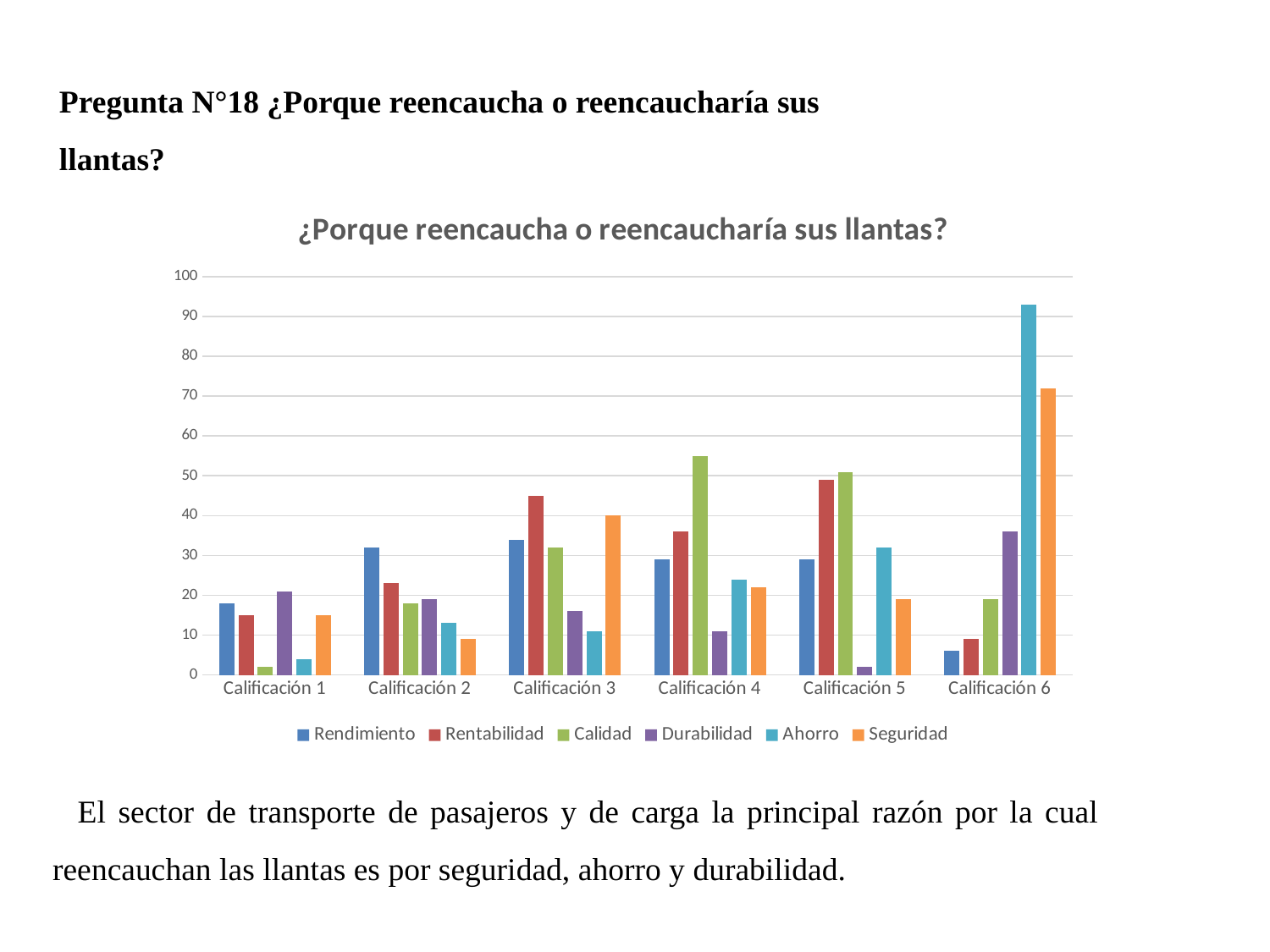
Which series has the highest bar in Calificación 6? Ahorro How many categories (Calificación groups) are shown on the x axis? 6 Which category contains the tallest bar in the whole chart? Calificación 6 How many series does the legend list? 6 Is the value for Rendimiento in Calificación 6 greater or less than 10? less Is the value for Calidad in Calificación 4 greater or less than 50? greater Is the value for Ahorro in Calificación 6 greater or less than 80? greater Which series has the lowest bar in Calificación 5? Durabilidad What kind of chart is shown on the slide? Bar chart In Calificación 3, which is larger: Rentabilidad or Seguridad? Rentabilidad What is the title of the chart? ¿Porque reencaucha o reencaucharía sus llantas?